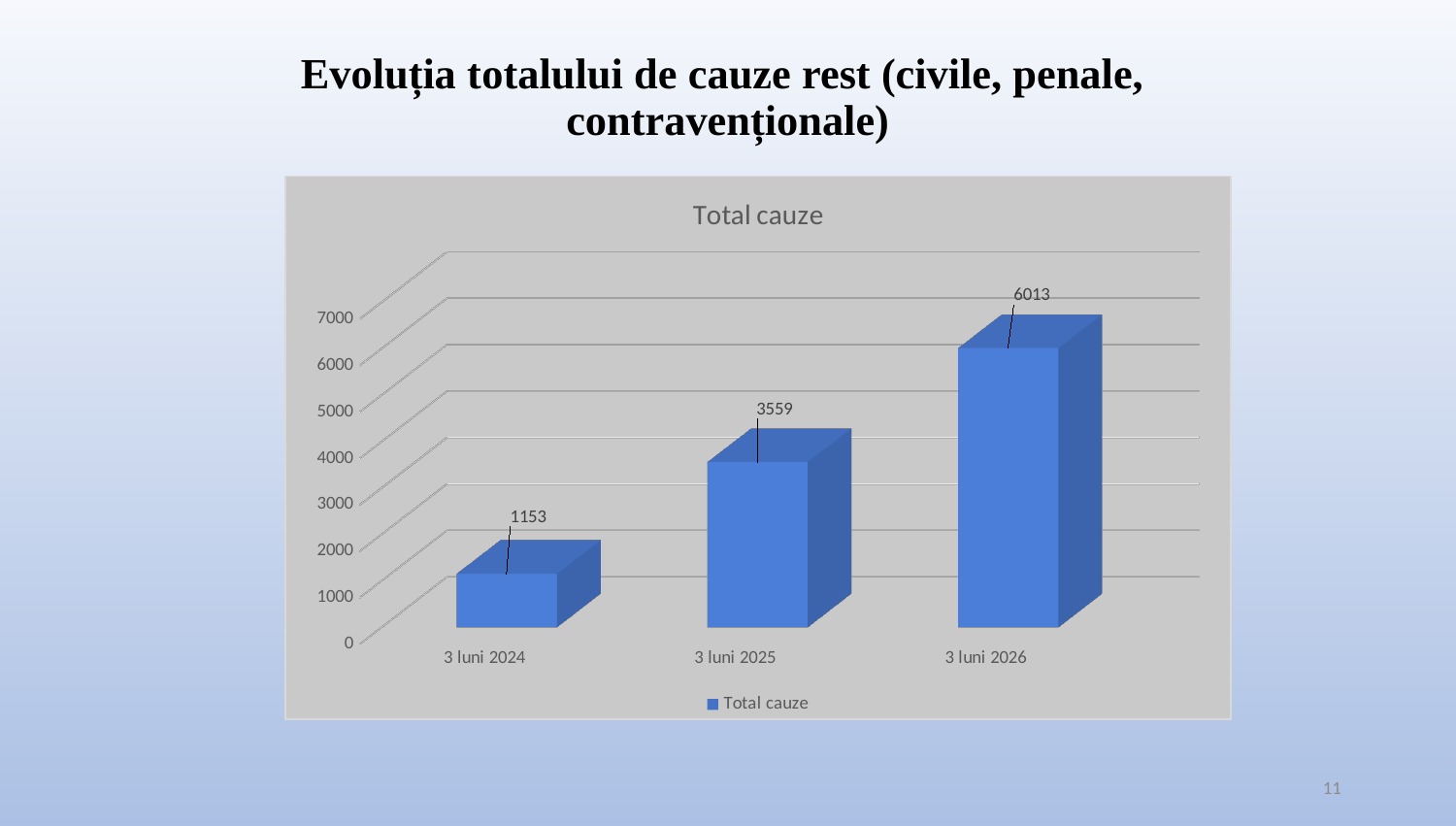
What kind of chart is shown? Bar chart How many categories are shown on the x axis? 3 How many series does the legend list? 1 What is the difference between the values for 3 luni 2026 and 3 luni 2025? 2454 What is the value for 3 luni 2024? 1153 Which category has the lowest value? 3 luni 2024 What is the value for 3 luni 2026? 6013 Do the values rise or fall from 3 luni 2024 to 3 luni 2026? Rise What is the value for 3 luni 2025? 3559 Which is larger, the value for 3 luni 2024 or the value for 3 luni 2025? 3 luni 2025 What is the difference between the values for 3 luni 2025 and 3 luni 2024? 2406 Which category has the highest value? 3 luni 2026